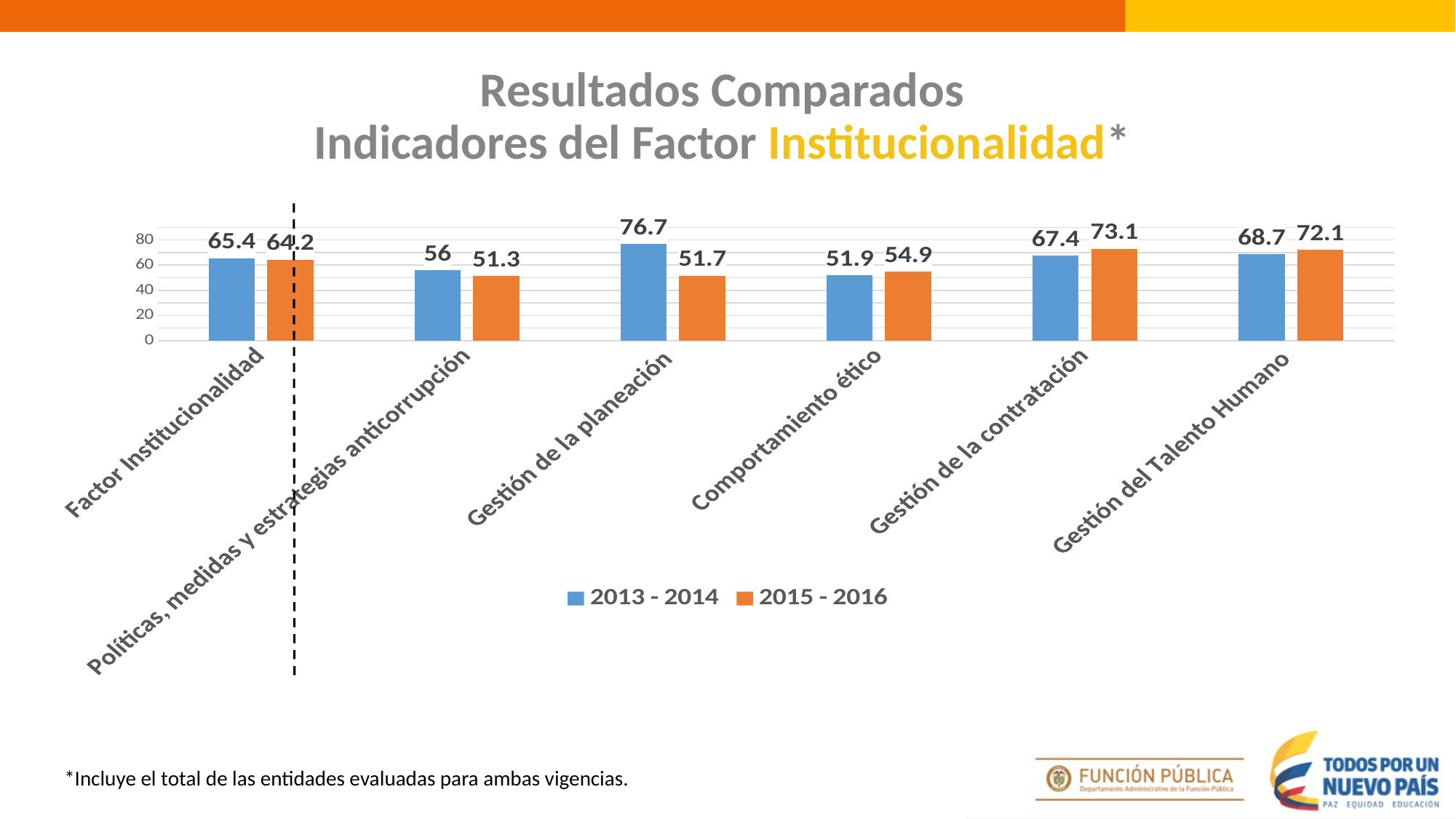
What is the difference between the 2015 - 2016 and 2013 - 2014 values for Gestión del Talento Humano? 3.4 What is the difference between the 2013 - 2014 and 2015 - 2016 values for Gestión de la planeación? 25 What is the 2015 - 2016 value for Factor Institucionalidad? 64.2 How many series does the legend list? 2 Which category has the highest 2013 - 2014 value? Gestión de la planeación What kind of chart is shown on the slide? Bar chart Which is larger for Comportamiento ético: the 2013 - 2014 value or the 2015 - 2016 value? 2015 - 2016 Which colour represents the 2015 - 2016 series? Orange Which category has the lowest 2015 - 2016 value? Políticas, medidas y estrategias anticorrupción What is the 2013 - 2014 value for Gestión de la planeación? 76.7 What is the 2015 - 2016 value for Gestión de la contratación? 73.1 How many categories are shown on the x axis? 6